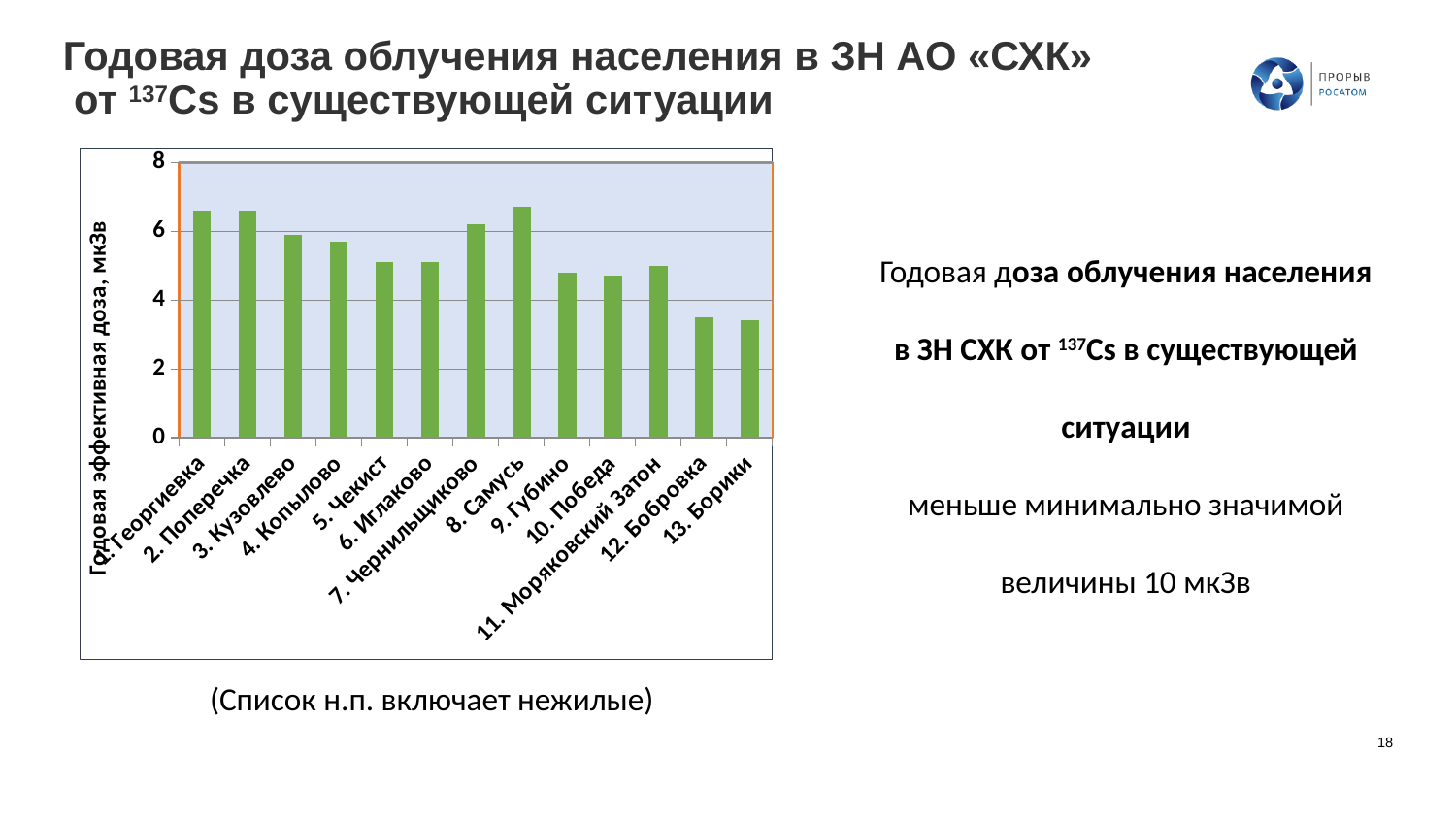
Which has the larger value, 8. Самусь or 9. Губино? 8. Самусь Is the value for 9. Губино greater or less than 4? greater What kind of chart is shown on the slide? bar chart Is the value for 10. Победа greater or less than 6? less Is the value for 1. Георгиевка greater or less than 6? greater Which has the larger value, 1. Георгиевка or 12. Бобровка? 1. Георгиевка How many settlements (categories) are plotted on the chart? 13 What is the label of the vertical axis of the chart? Годовая эффективная доза, мкЗв Which has the larger value, 7. Чернильщиково or 10. Победа? 7. Чернильщиково